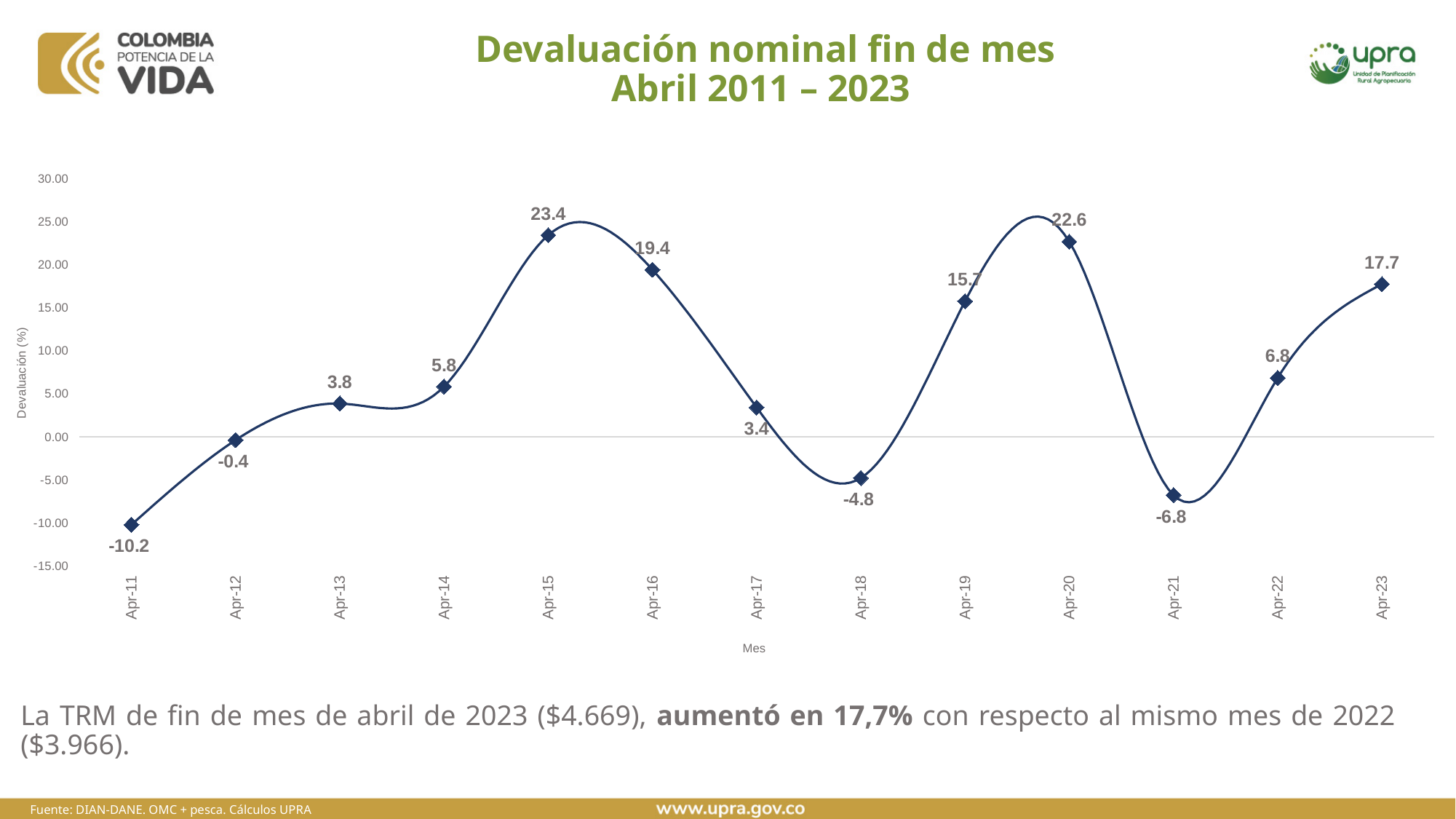
What is the label of the vertical axis? Devaluación (%) How many data points are plotted on the chart? 13 What is the value for Apr-11? -10.2 What kind of chart is shown on the slide? line chart Which is larger, the value for Apr-20 or the value for Apr-19? Apr-20 What is the difference between the values for Apr-15 and Apr-16? 4.0 Which month has the highest value? Apr-15 What is the value for Apr-23? 17.7 What is the value for Apr-18? -4.8 What is the difference between the values for Apr-23 and Apr-22? 10.9 Which month has the lowest value? Apr-11 Is the value for Apr-19 greater or less than 10.00? greater